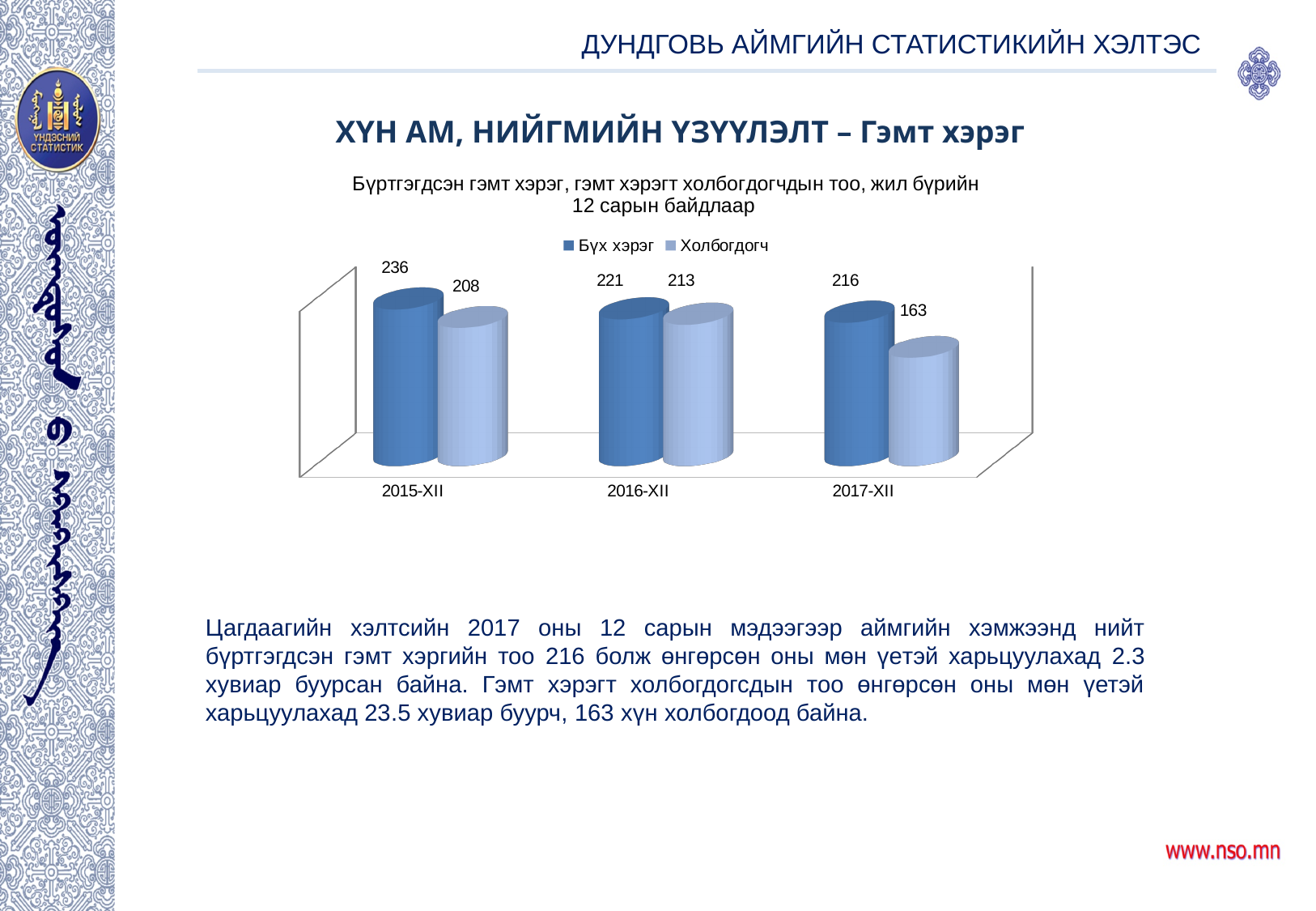
How many periods are shown on the x axis? 3 Which is larger in 2016-XII: Бүх хэрэг or Холбогдогч? Бүх хэрэг Which period has the highest value for Бүх хэрэг? 2015-XII What kind of chart is shown? Bar chart How many series does the legend list? 2 What is the value of Бүх хэрэг for 2015-XII? 236 What is the difference between Бүх хэрэг in 2015-XII and 2016-XII? 15 Does the value of Бүх хэрэг rise or fall from 2015-XII to 2017-XII? Fall What is the value of Холбогдогч for 2016-XII? 213 What is the value of Холбогдогч for 2017-XII? 163 What is the difference between Бүх хэрэг and Холбогдогч in 2017-XII? 53 Which period has the lowest value for Холбогдогч? 2017-XII